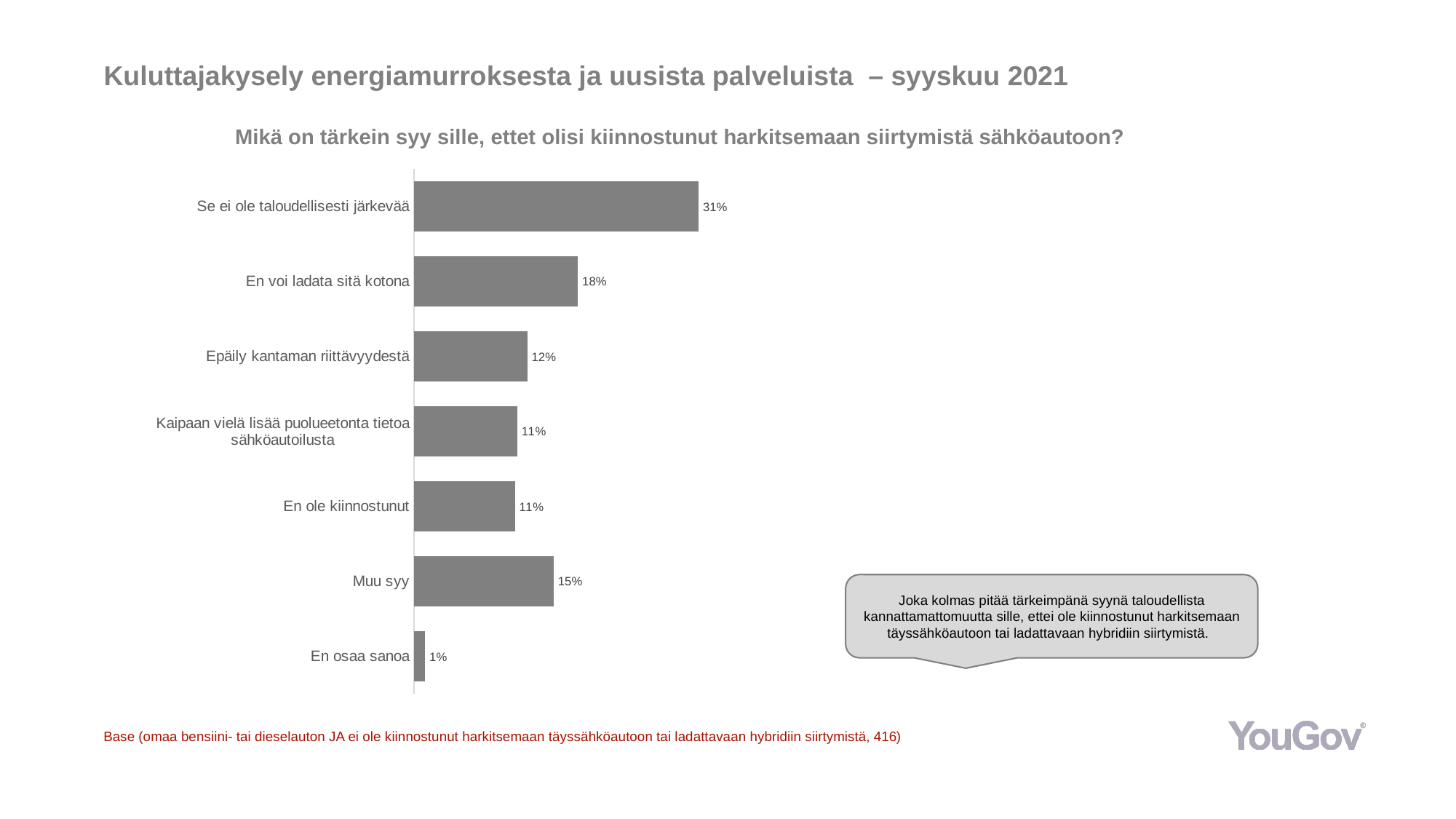
What is the difference between "Muu syy" and "Epäily kantaman riittävyydestä"? 3% Which is larger: "En voi ladata sitä kotona" or "Muu syy"? En voi ladata sitä kotona Which category has the lowest value? En osaa sanoa What is the value for "En voi ladata sitä kotona"? 18% What is the value for "En osaa sanoa"? 1% Which category has the highest value? Se ei ole taloudellisesti järkevää What is the difference between "Se ei ole taloudellisesti järkevää" and "En voi ladata sitä kotona"? 13% What percentage is shown for "Se ei ole taloudellisesti järkevää"? 31% What kind of chart is shown on the slide? Bar chart How many categories are shown in the chart? 7 What is the title of the chart? Mikä on tärkein syy sille, ettet olisi kiinnostunut harkitsemaan siirtymistä sähköautoon? What percentage is shown for "Muu syy"? 15%